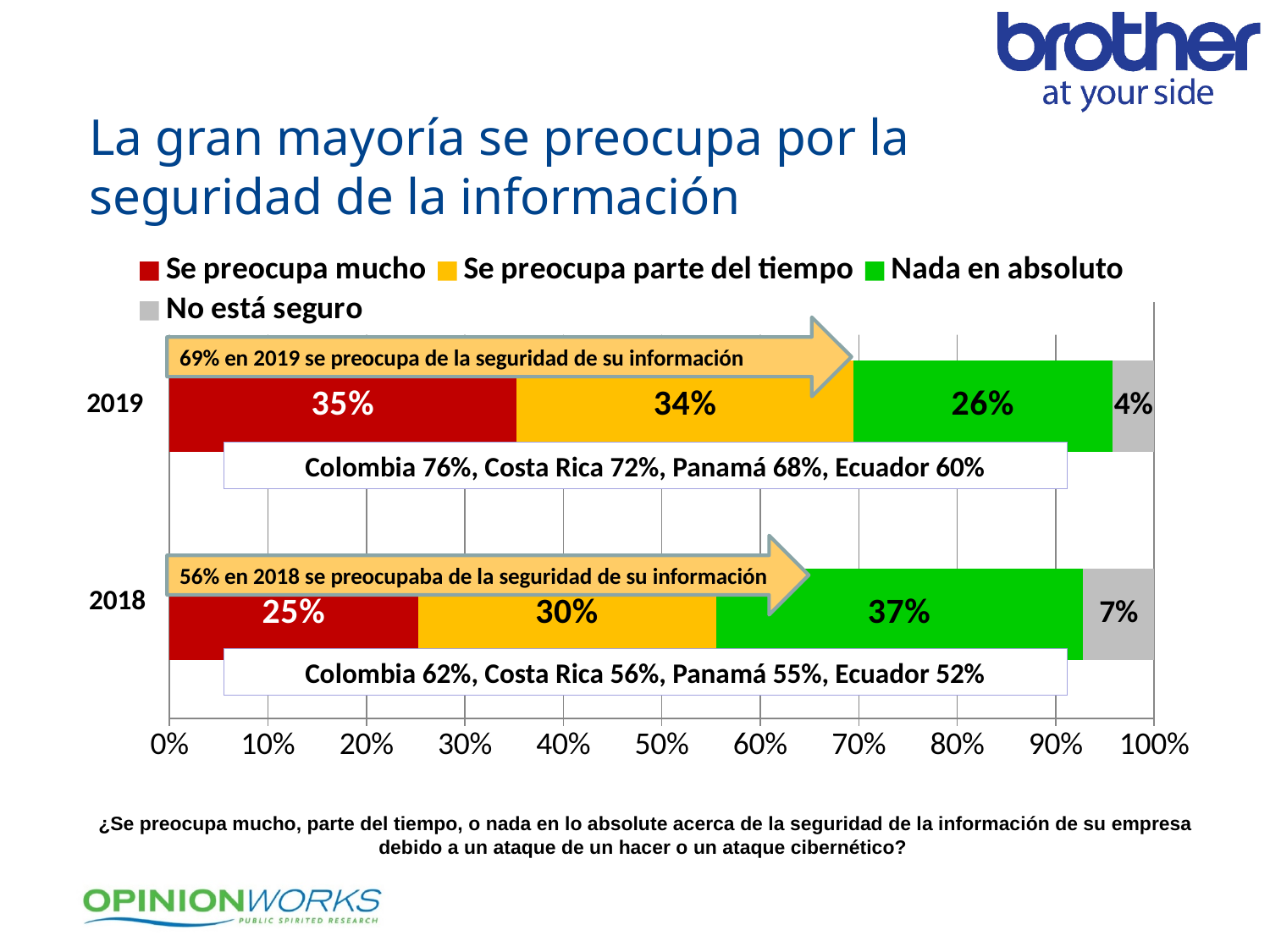
What is the value for "Se preocupa mucho" in 2019? 35% What is the value for "No está seguro" in 2019? 4% What is the difference between the "Nada en absoluto" values for 2018 and 2019? 11% Which series has the smallest value in the 2019 bar? No está seguro How many years (categories) are shown in the chart? 2 What kind of chart is shown on the slide? Stacked bar chart How many series does the legend list? 4 Which year has the higher value for "Se preocupa mucho", 2018 or 2019? 2019 What is the value for "Se preocupa parte del tiempo" in 2018? 30% What is the value for "Nada en absoluto" in 2018? 37% Which series has the largest value in the 2018 bar? Nada en absoluto What is the difference between the "Se preocupa mucho" values for 2019 and 2018? 10%